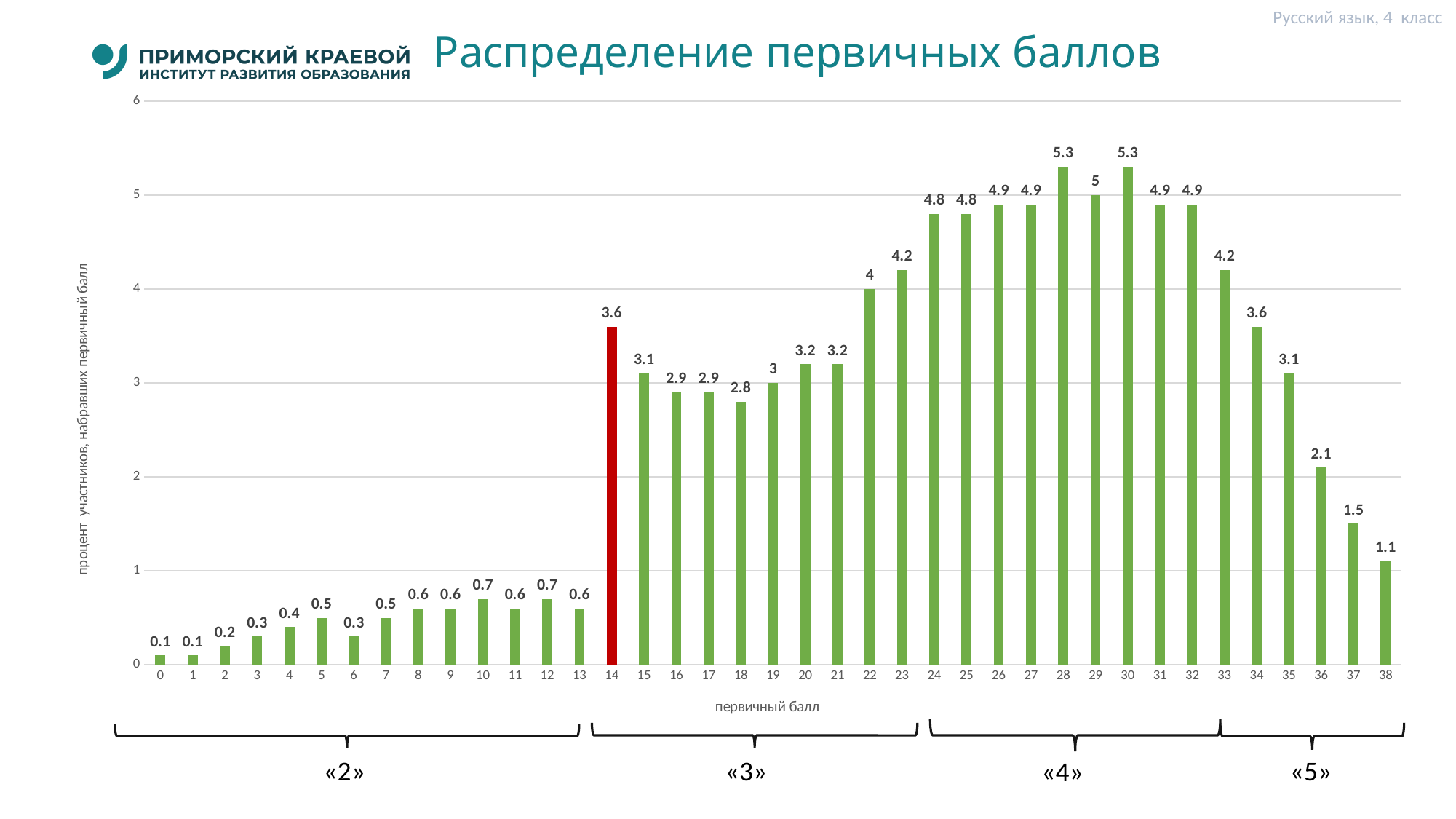
Which has a larger value, primary score 22 or primary score 33? 33 What is the difference between the values for primary scores 14 and 13? 3 Which primary scores have the highest value on the chart? 28 and 30 How many primary score categories are plotted on the x axis? 39 What is the difference between the values for primary scores 28 and 36? 3.2 What is the value for primary score 29? 5 Which primary score is highlighted with a red bar? 14 Is the value for primary score 36 greater or less than 2? greater What is the value for primary score 38? 1.1 What is the highest value shown on the chart? 5.3 What type of chart is shown on the slide? bar chart What is the value for primary score 14? 3.6